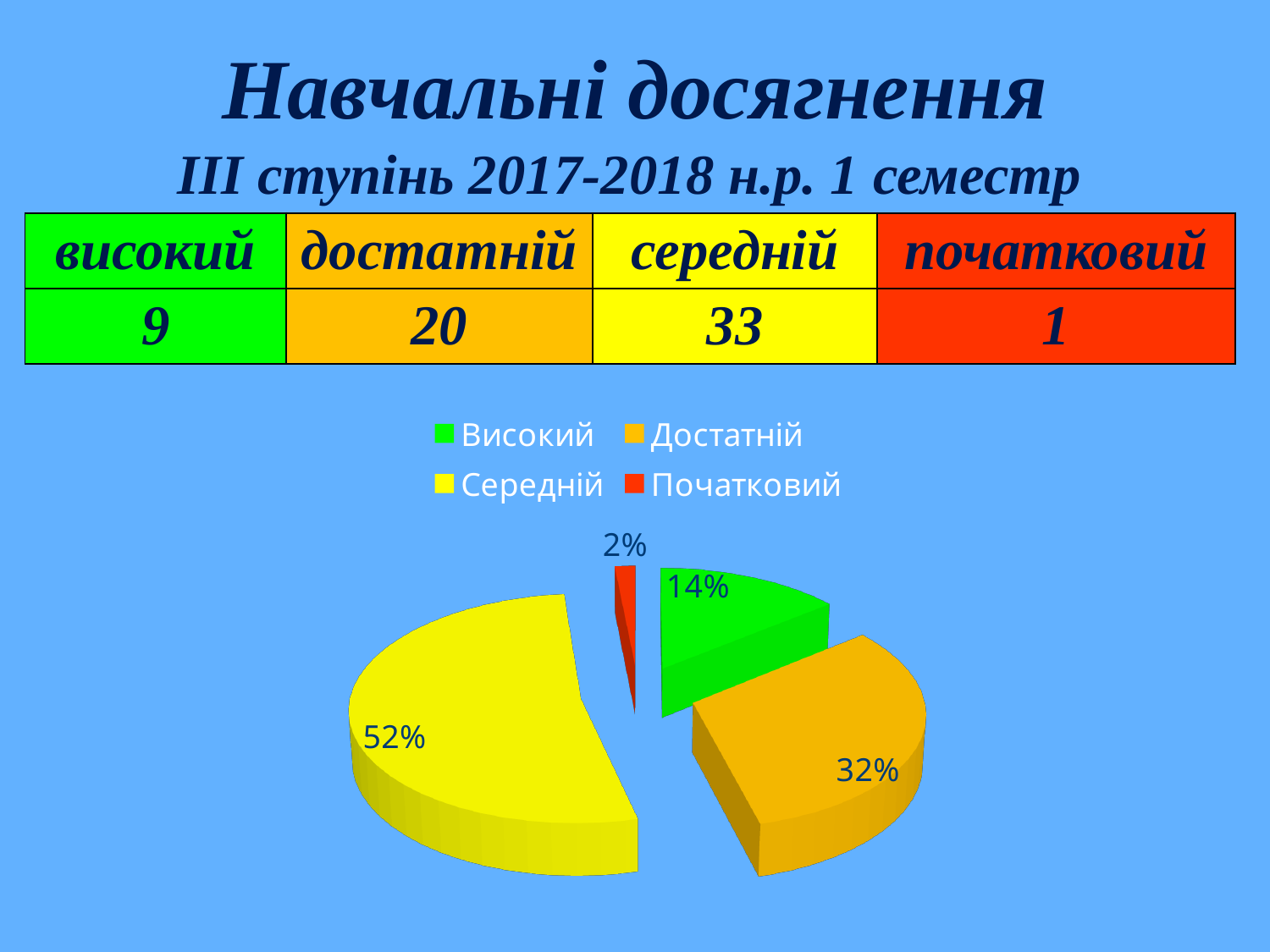
How many slices does the pie chart have? 4 What is the difference in percentage points between the Середній and Достатній slices? 20 Which category has the smallest slice of the pie? Початковий What type of chart is shown on the slide? Pie chart What percentage is shown for the Високий slice? 14% Which category has the largest slice of the pie? Середній What share of the pie does the Середній slice represent? 52% What percentage is shown for the Початковий slice? 2% Which slice is larger, Високий or Достатній? Достатній What colour is the Середній slice in the pie chart? Yellow What percentage is shown for the Достатній slice? 32% What is the difference in percentage points between the Високий and Початковий slices? 12